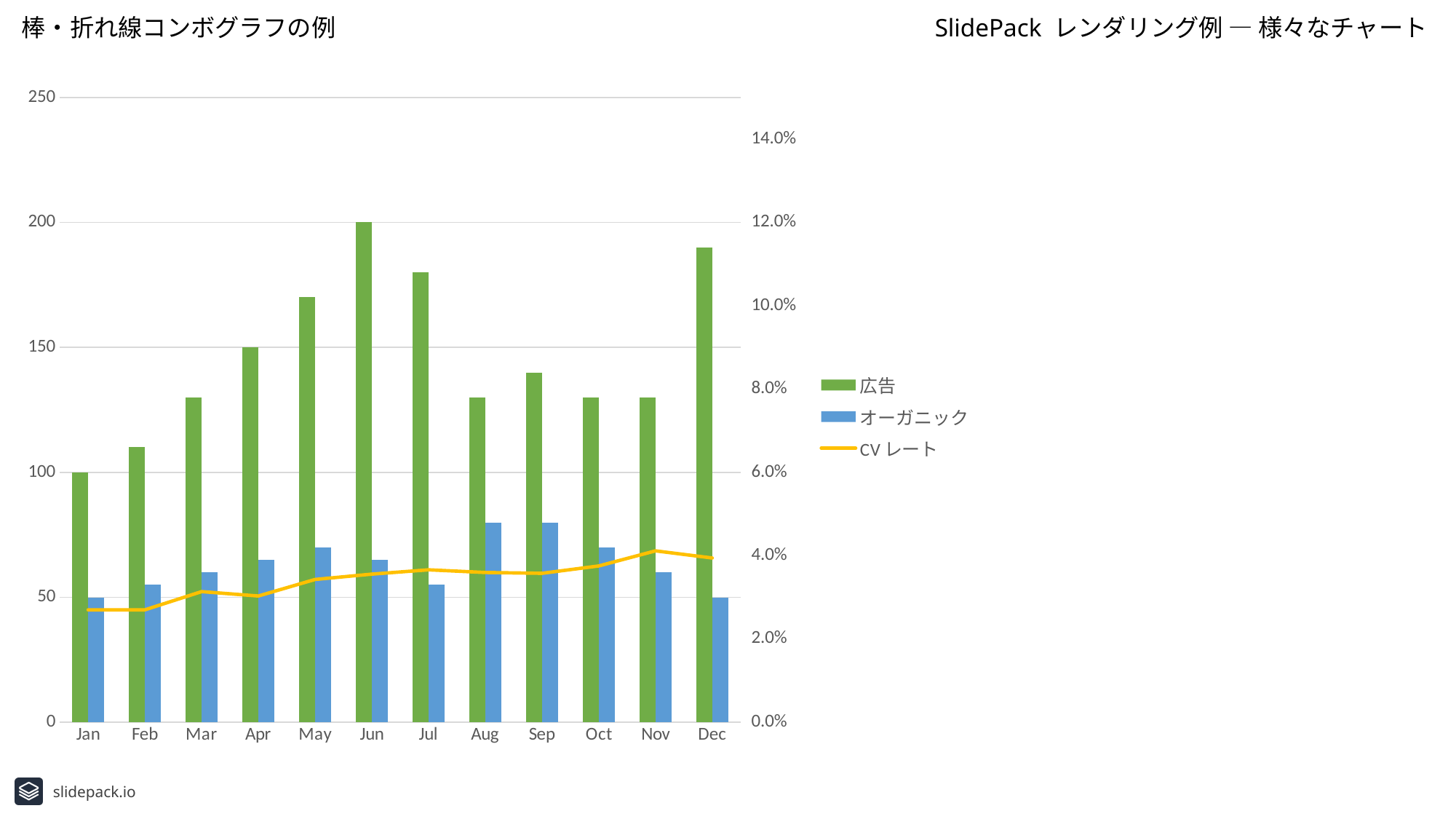
What is the 広告 value for Apr? 150 What kind of chart is shown on the slide? A combined bar and line chart Is the CV レート value for Jan greater or less than 4.0%? less What is the 広告 value for Jan? 100 Which is larger, the 広告 value for Jun or for Dec? Jun How many series does the legend list? 3 What is the 広告 value for Jun? 200 How many months are shown on the x axis? 12 Is the 広告 value for Dec greater or less than 150? greater Which month has the lowest 広告 bar? Jan Does the CV レート line generally rise or fall from Jan to Dec? rise Which month has the highest 広告 bar? Jun